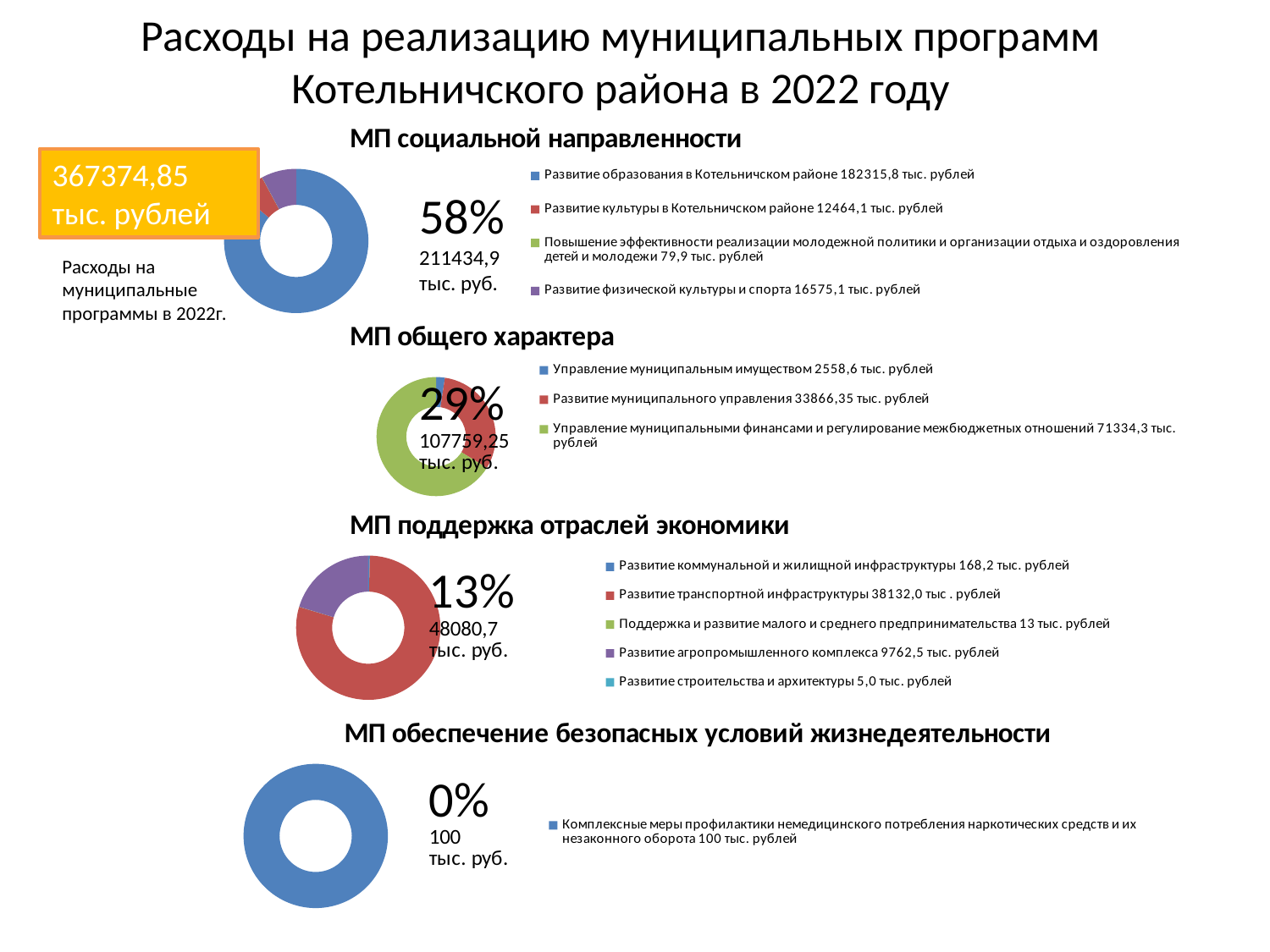
In the "МП поддержка отраслей экономики" chart, how many categories does the legend list? 5 What is the total spending shown for "МП общего характера"? 107759,25 тыс. руб. What share of total municipal programme spending does "МП социальной направленности" account for, as shown on the slide? 58% In the "МП поддержка отраслей экономики" chart, which is larger: "Развитие транспортной инфраструктуры" or "Развитие агропромышленного комплекса"? Развитие транспортной инфраструктуры In the "МП общего характера" chart, which category has the highest value? Управление муниципальными финансами и регулирование межбюджетных отношений In the "МП общего характера" chart, what is the value for "Развитие муниципального управления"? 33866,35 тыс. рублей In the "МП социальной направленности" chart, how many categories does the legend list? 4 In the "МП социальной направленности" chart, which category has the lowest value? Повышение эффективности реализации молодежной политики и организации отдыха и оздоровления детей и молодежи In the "МП поддержка отраслей экономики" chart, what is the difference between "Развитие агропромышленного комплекса" (9762,5) and "Развитие коммунальной и жилищной инфраструктуры" (168,2)? 9594,3 тыс. рублей What kind of chart is used for "МП социальной направленности"? Doughnut (pie) chart In the "МП социальной направленности" chart, what is the value for "Развитие образования в Котельничском районе"? 182315,8 тыс. рублей In the "МП обеспечение безопасных условий жизнедеятельности" chart, what is the value for "Комплексные меры профилактики немедицинского потребления наркотических средств и их незаконного оборота"? 100 тыс. рублей